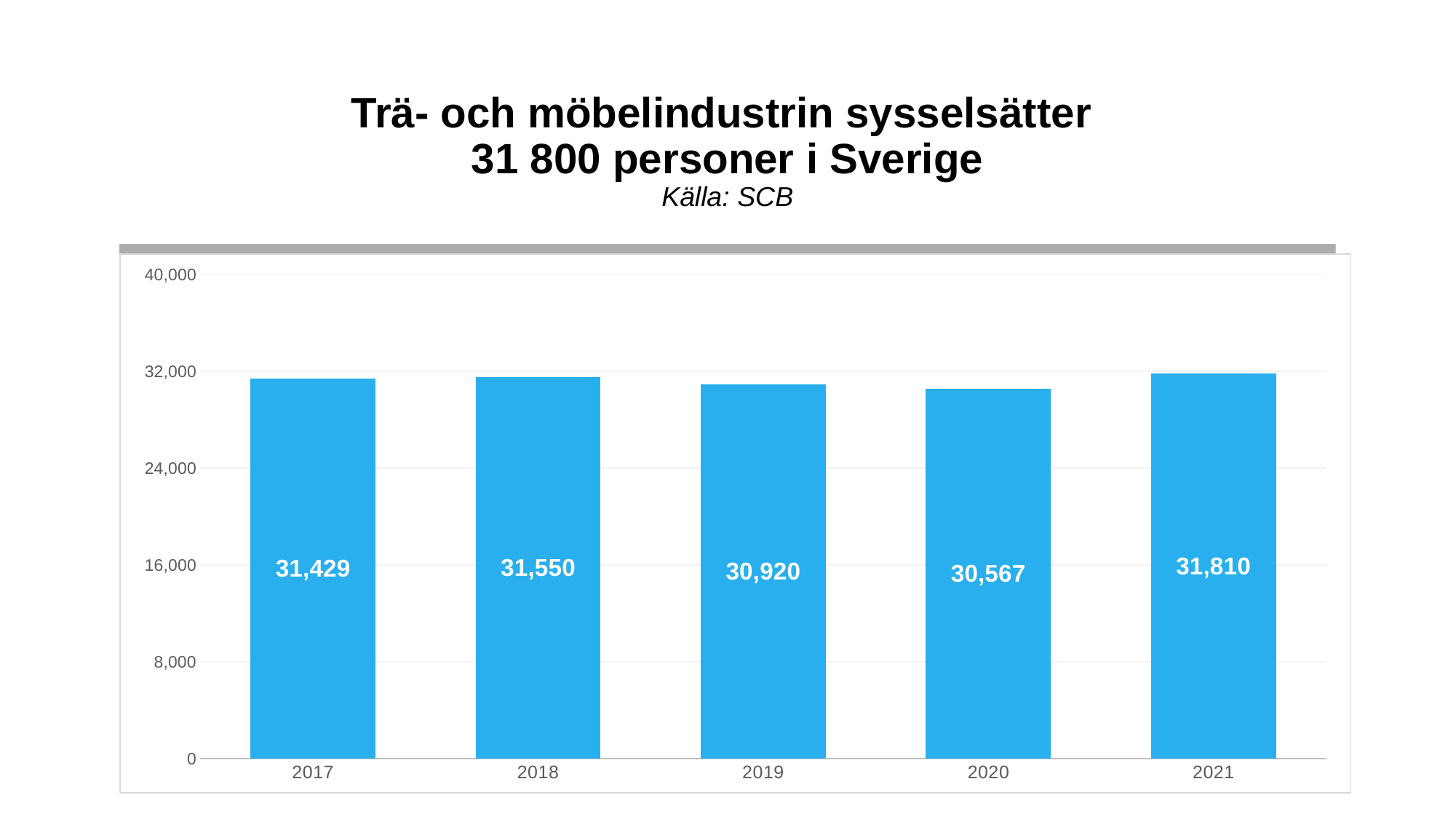
Is the value for 2019 greater or less than 32,000? less Which year has the highest value? 2021 What kind of chart is shown on the slide? bar chart How many years are shown on the x axis? 5 What is the difference between the values for 2021 and 2020? 1,243 What is the value for 2021? 31,810 Which year has the lowest value? 2020 What is the difference between the values for 2018 and 2017? 121 What source is cited below the chart title? SCB What is the value for 2017? 31,429 What is the value for 2020? 30,567 Which is larger, the value for 2019 or the value for 2018? 2018